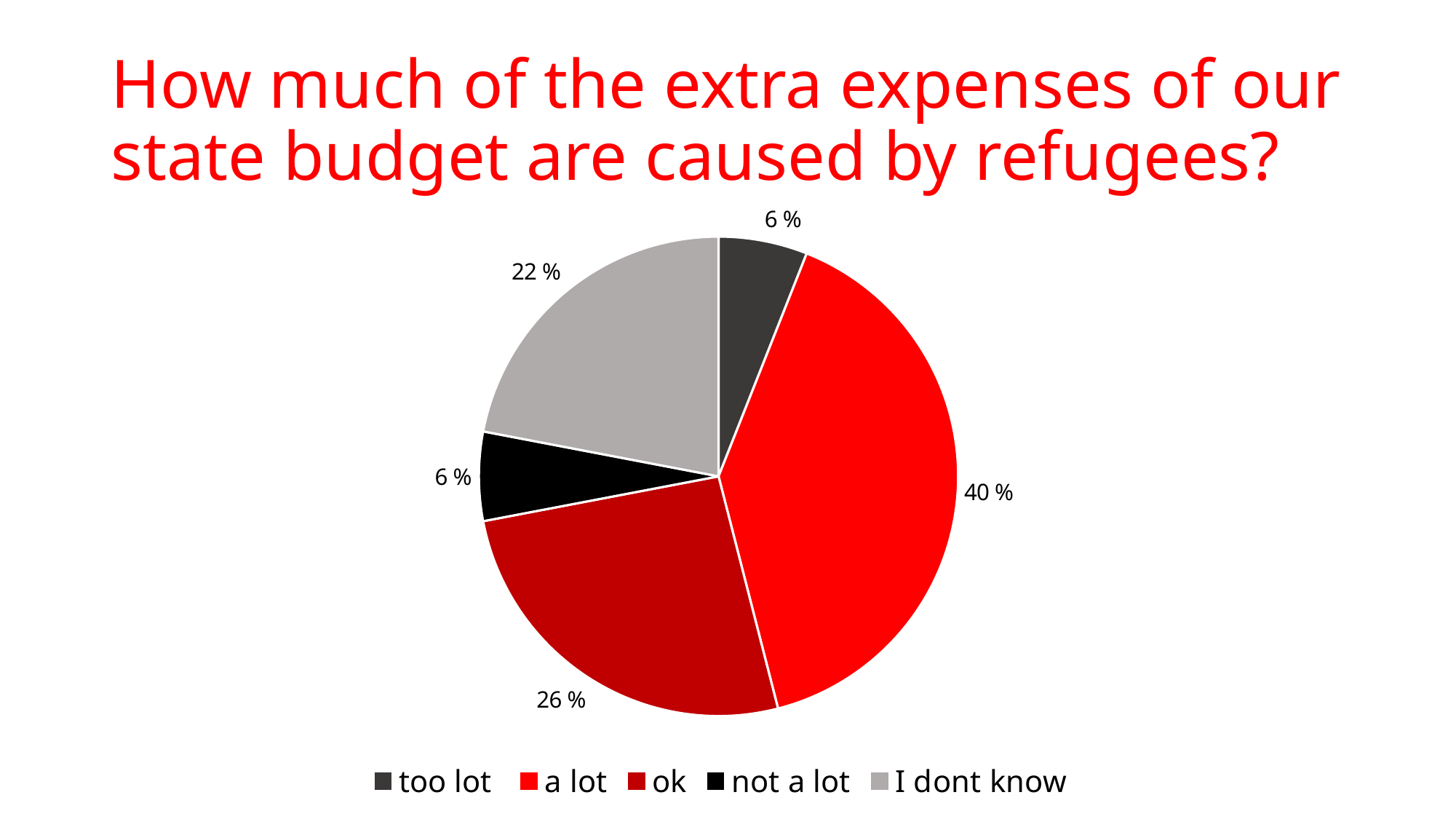
How many entries does the legend list? 5 What is the value shown for the "too lot" slice? 6 % Which slice is larger, "ok" or "I dont know"? ok What is the value shown for the "not a lot" slice? 6 % What is the title of the slide above the chart? How much of the extra expenses of our state budget are caused by refugees? What share of the pie does the "a lot" slice represent? 40 % What is the value shown for the "I dont know" slice? 22 % What kind of chart is shown on the slide? pie chart How many slices does the pie chart have? 5 What is the value shown for the "ok" slice? 26 % What is the difference in percentage points between the "a lot" slice and the "ok" slice? 14 Which category has the largest slice of the pie? a lot